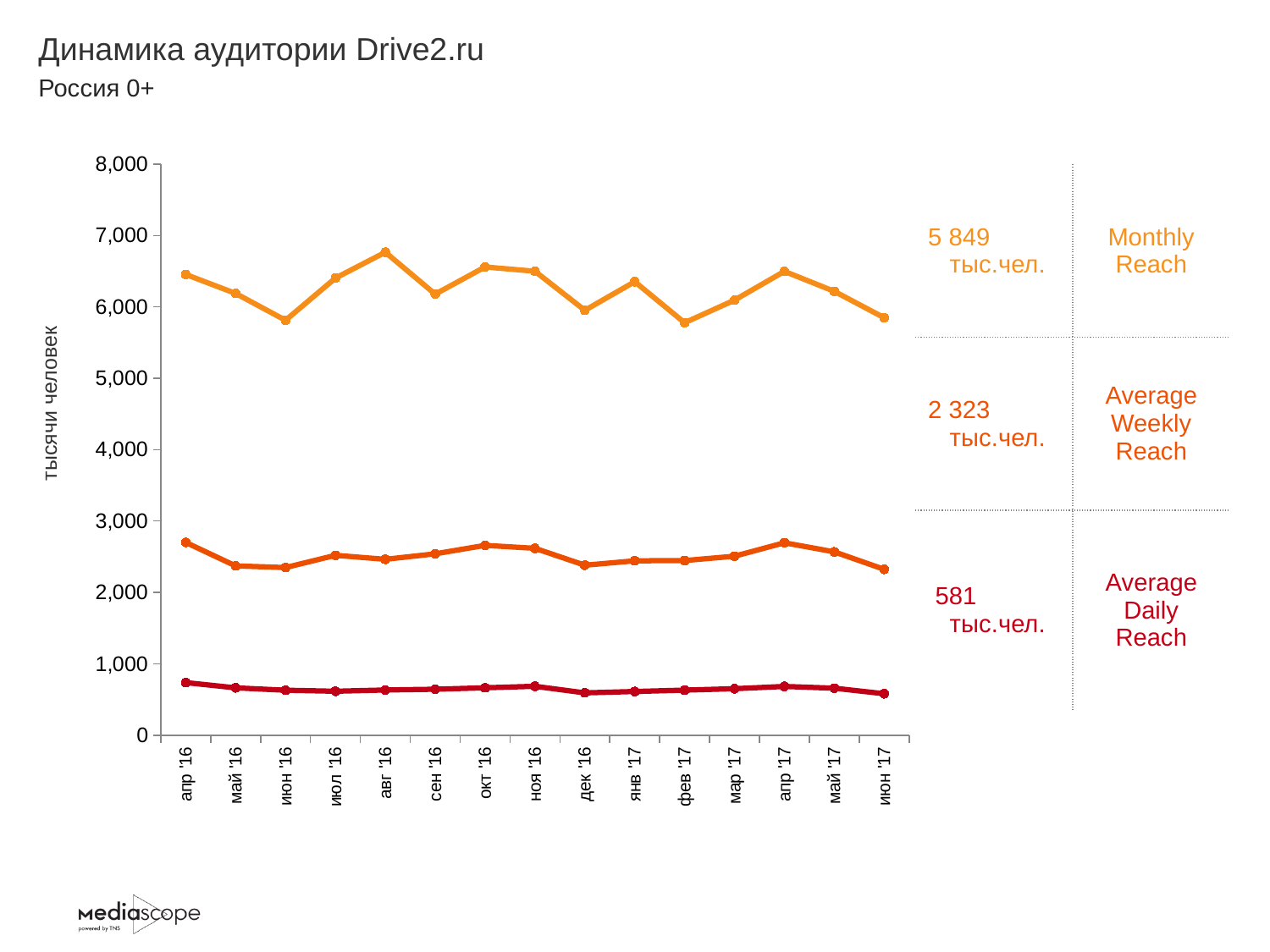
What is the Monthly Reach value shown for июн '17? 5 849 тыс.чел. Which is higher for Monthly Reach: авг '16 or дек '16? авг '16 How many monthly data points are plotted along the x axis? 15 Is the Monthly Reach value for июн '16 greater or less than 6,000? less Is the Average Daily Reach value for апр '16 greater or less than 1,000? less How many series are plotted on the chart? 3 What kind of chart is shown on the slide? line chart What is the difference between the Monthly Reach and the Average Weekly Reach values shown for июн '17? 3 526 тыс.чел. What is the Average Daily Reach value shown for июн '17? 581 тыс.чел. What is the Average Weekly Reach value shown for июн '17? 2 323 тыс.чел. In which month does the Monthly Reach line reach its highest point? авг '16 Does the Monthly Reach line rise or fall from апр '17 to июн '17? fall